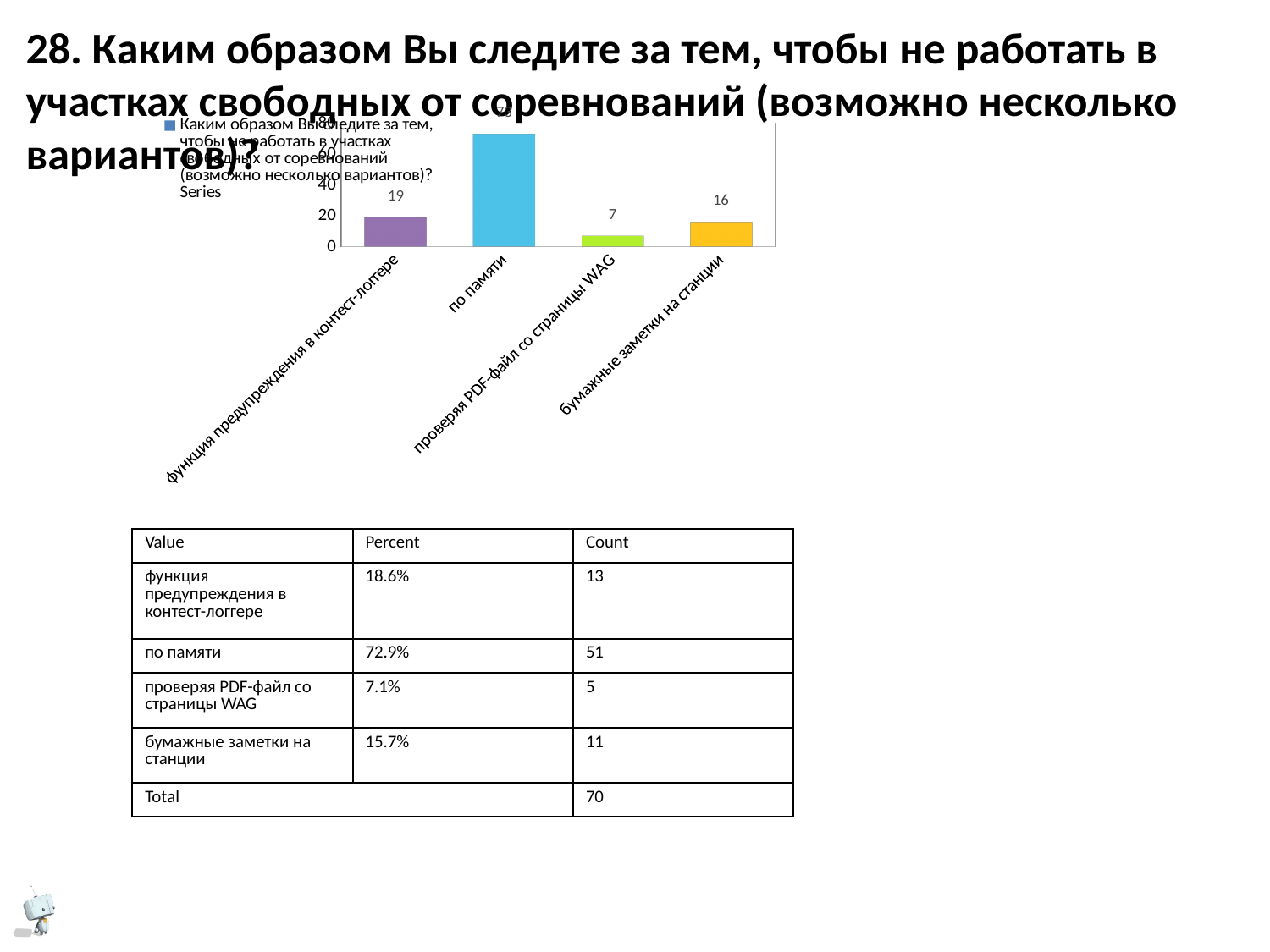
What is the difference between the values for "функция предупреждения в контест-логгере" and "бумажные заметки на станции" in the chart? 3 Which is larger in the chart: the value for "функция предупреждения в контест-логгере" or for "бумажные заметки на станции"? функция предупреждения в контест-логгере What is the difference between the values for "функция предупреждения в контест-логгере" and "проверяя PDF-файл со страницы WAG" in the chart? 12 What is the value for "проверяя PDF-файл со страницы WAG" in the bar chart? 7 What is the value for "функция предупреждения в контест-логгере" in the bar chart? 19 Is the value for "по памяти" in the chart greater or less than 60? greater What kind of chart is shown on the slide? bar chart Which category has the highest bar in the chart? по памяти What is the value for "бумажные заметки на станции" in the bar chart? 16 How many series does the chart's legend list? 1 How many categories are shown on the x axis of the chart? 4 Which category has the lowest bar in the chart? проверяя PDF-файл со страницы WAG